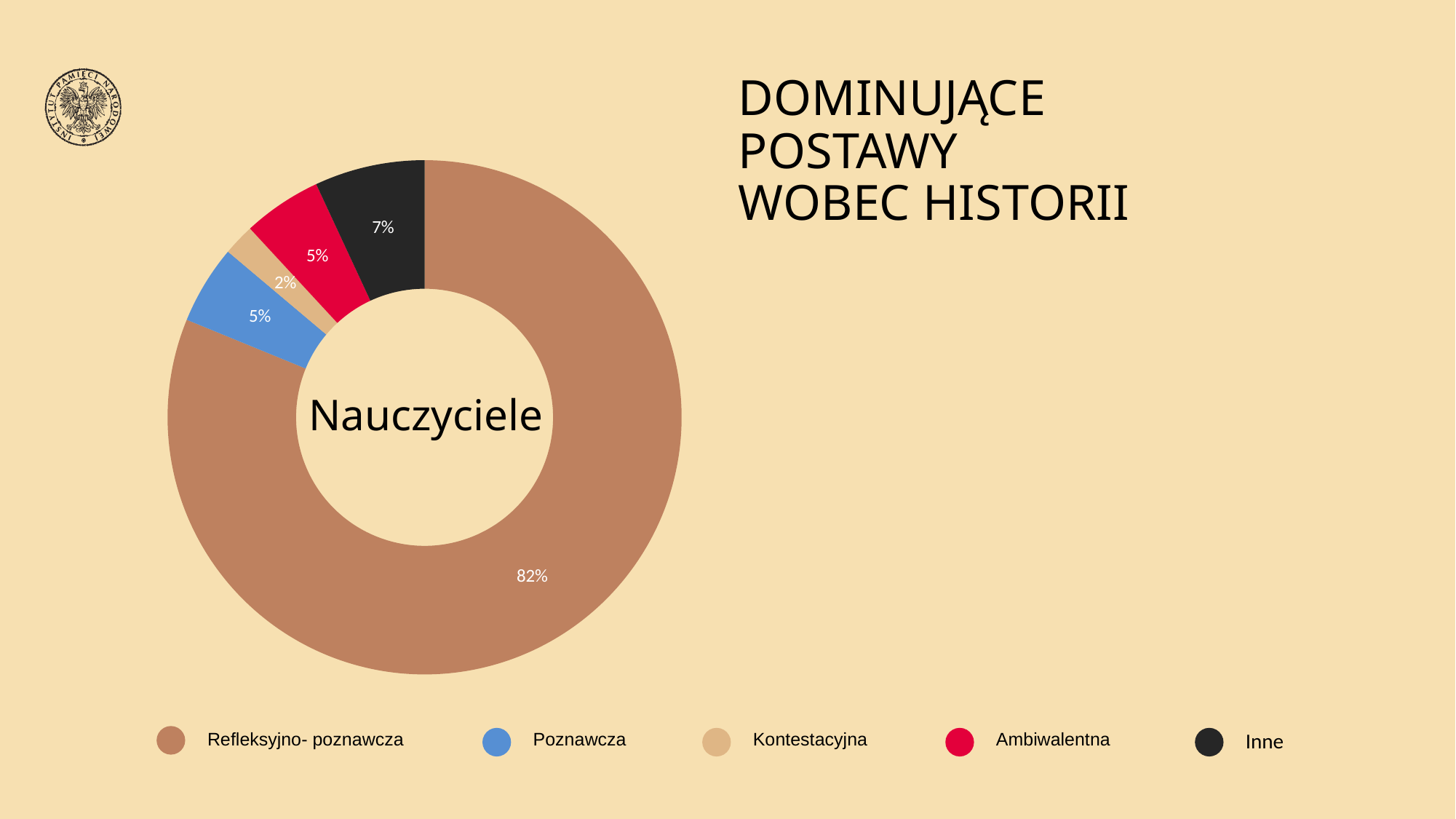
What is the value shown for Ambiwalentna? 5% What is the difference between the shares of Refleksyjno- poznawcza and Inne? 75% Which is larger, the share for Inne or the share for Poznawcza? Inne Which colour represents Ambiwalentna in the legend? Red Which category has the largest share of the chart? Refleksyjno- poznawcza Which category has the smallest share of the chart? Kontestacyjna What share of the donut chart does Refleksyjno- poznawcza take? 82% What word is written in the centre of the donut chart? Nauczyciele What is the value shown for Inne? 7% What is the value shown for Kontestacyjna? 2% How many categories does the legend list? 5 What kind of chart is shown on the slide? Donut (pie) chart